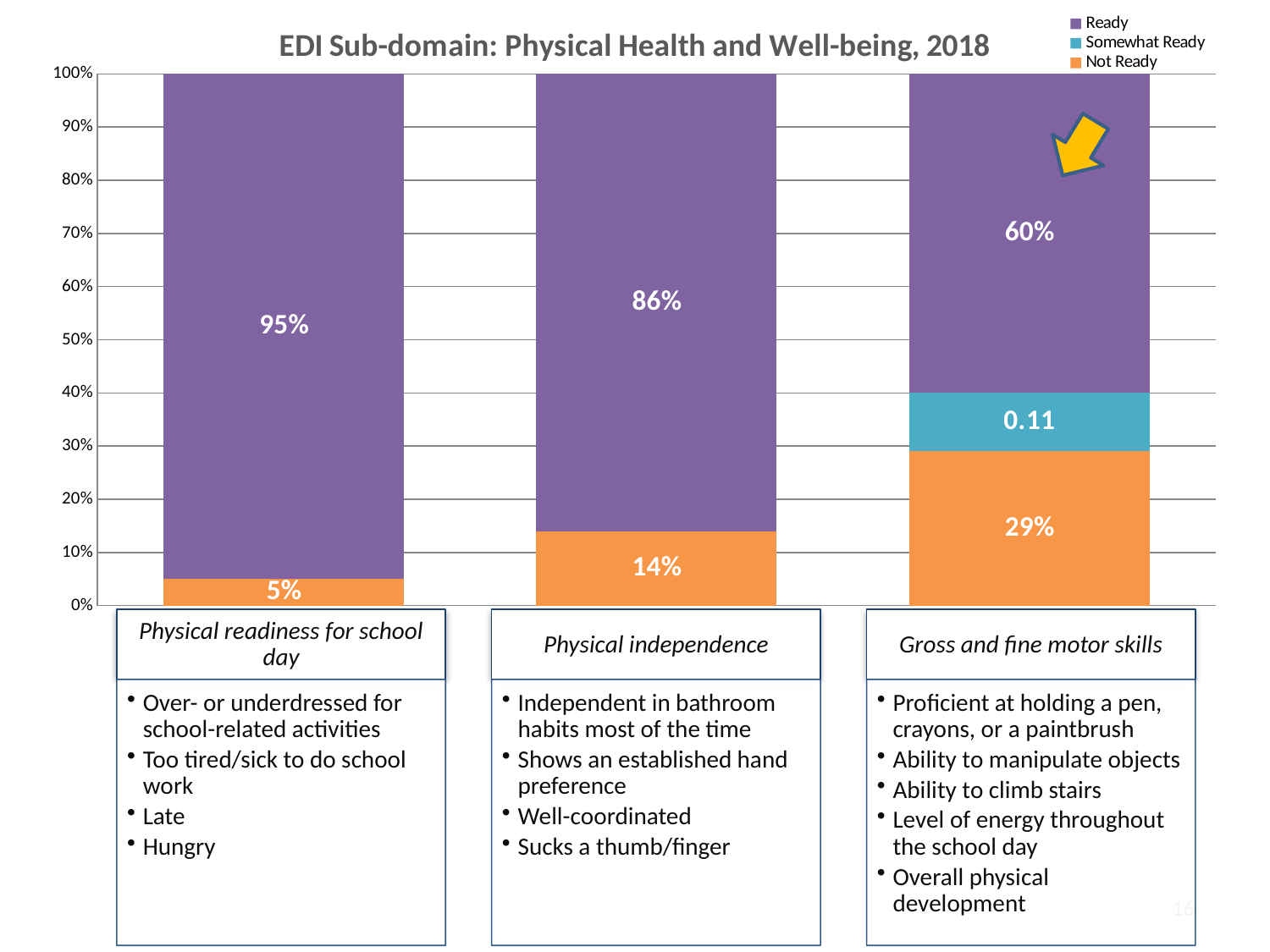
What is the difference between the Ready values for Physical readiness for school day and Physical independence? 9% What is the title of the chart? EDI Sub-domain: Physical Health and Well-being, 2018 How many categories are shown on the x axis? 3 What is the Somewhat Ready value for Gross and fine motor skills? 0.11 How many series does the legend list? 3 Which category has the lowest Ready value? Gross and fine motor skills What is the Ready value for Physical readiness for school day? 95% What is the Not Ready value for Physical independence? 14% Which category has the highest Ready value? Physical readiness for school day Which is larger, the Not Ready value for Physical independence or the Not Ready value for Gross and fine motor skills? Gross and fine motor skills What is the Not Ready value for Gross and fine motor skills? 29% What kind of chart is shown on the slide? Stacked bar chart